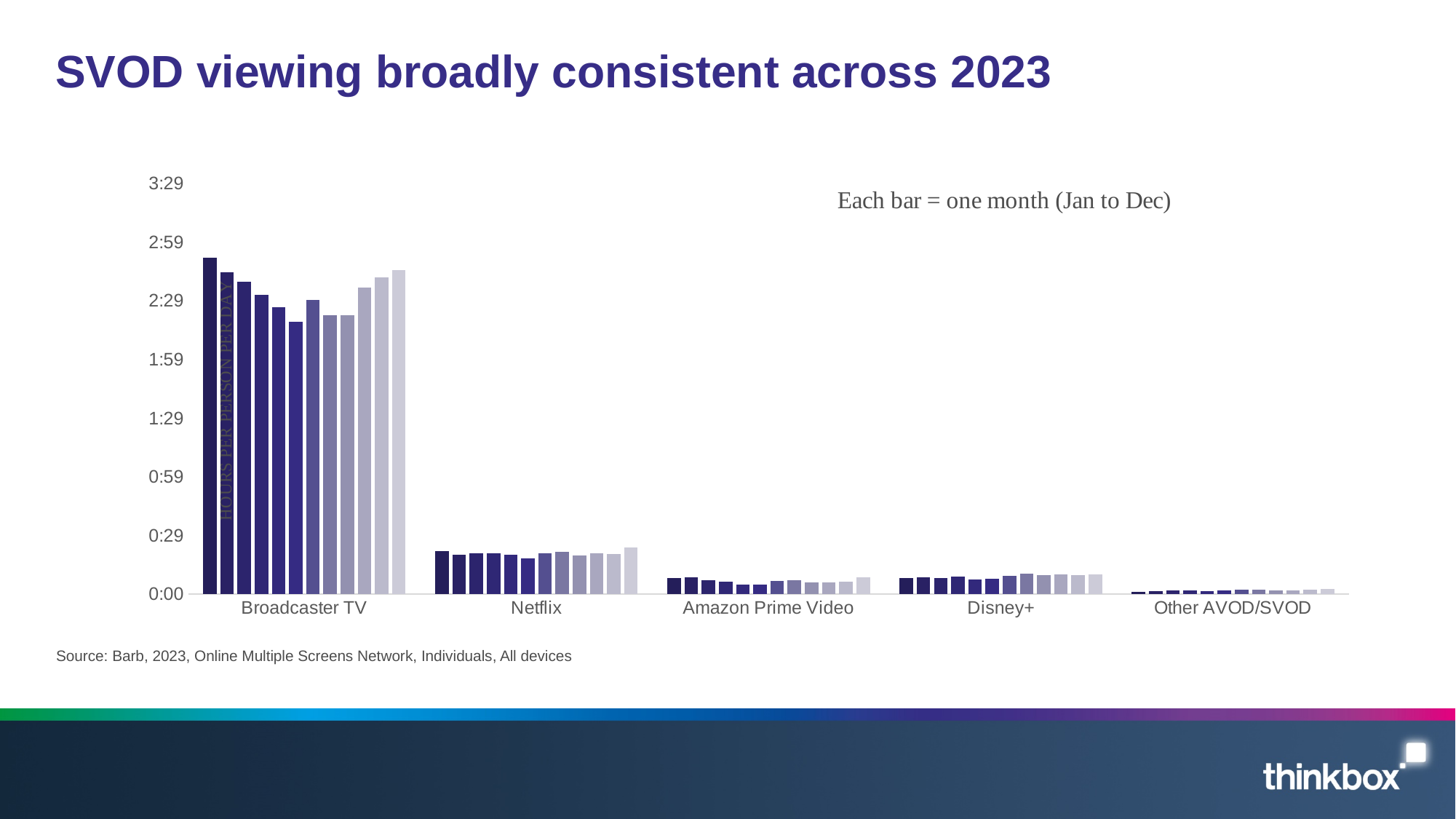
Which category has the lowest viewing hours per person per day? Other AVOD/SVOD Are the values for Amazon Prime Video greater or less than 0:29? less What is the label on the vertical axis of the chart? HOURS PER PERSON PER DAY How many categories are shown along the x axis of the chart? 5 What is the title of the slide? SVOD viewing broadly consistent across 2023 How many bars are shown for each category, according to the note on the chart? 12 Which category has the highest viewing hours per person per day? Broadcaster TV Which category has higher bars, Broadcaster TV or Netflix? Broadcaster TV What kind of chart is shown on the slide? bar chart Which category has higher bars, Netflix or Disney+? Netflix Are the values for Broadcaster TV greater or less than 1:59? greater Are the values for Netflix greater or less than 0:29? less